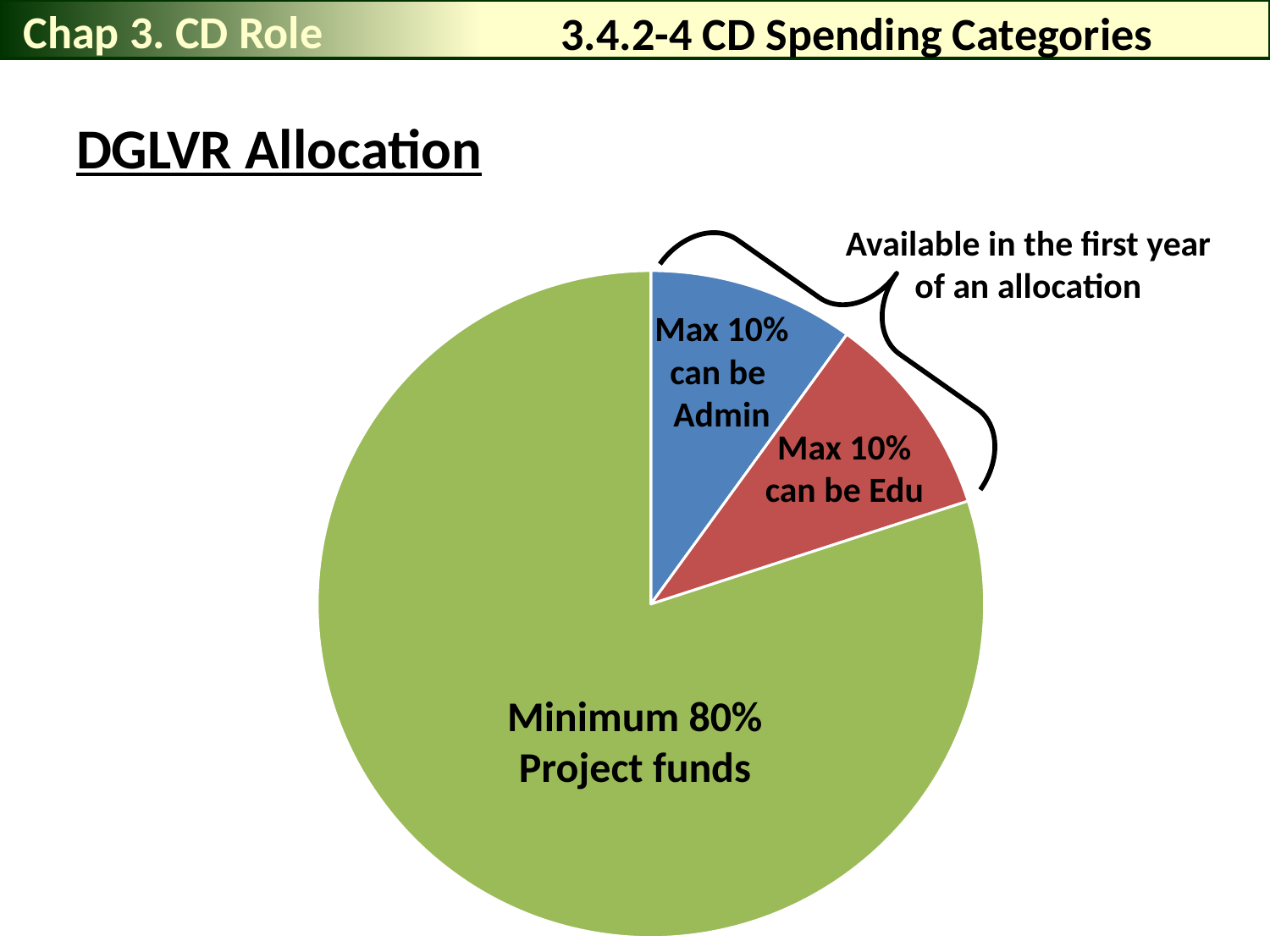
What share of the pie is labelled for Project funds? Minimum 80% What is the combined share of the Admin and Edu slices? 20% Which slice of the pie is the largest? Minimum 80% Project funds What share of the pie is labelled for Edu? Max 10% Which slices does the annotation 'Available in the first year of an allocation' point to? Admin and Edu What is the title above the pie chart? DGLVR Allocation What share of the pie is labelled for Admin? Max 10% Which is larger, the Project funds slice or the Admin slice? Project funds How many slices does the pie chart have? 3 What kind of chart is shown on the slide? pie chart What is the difference between the Project funds share and the Edu share? 70%